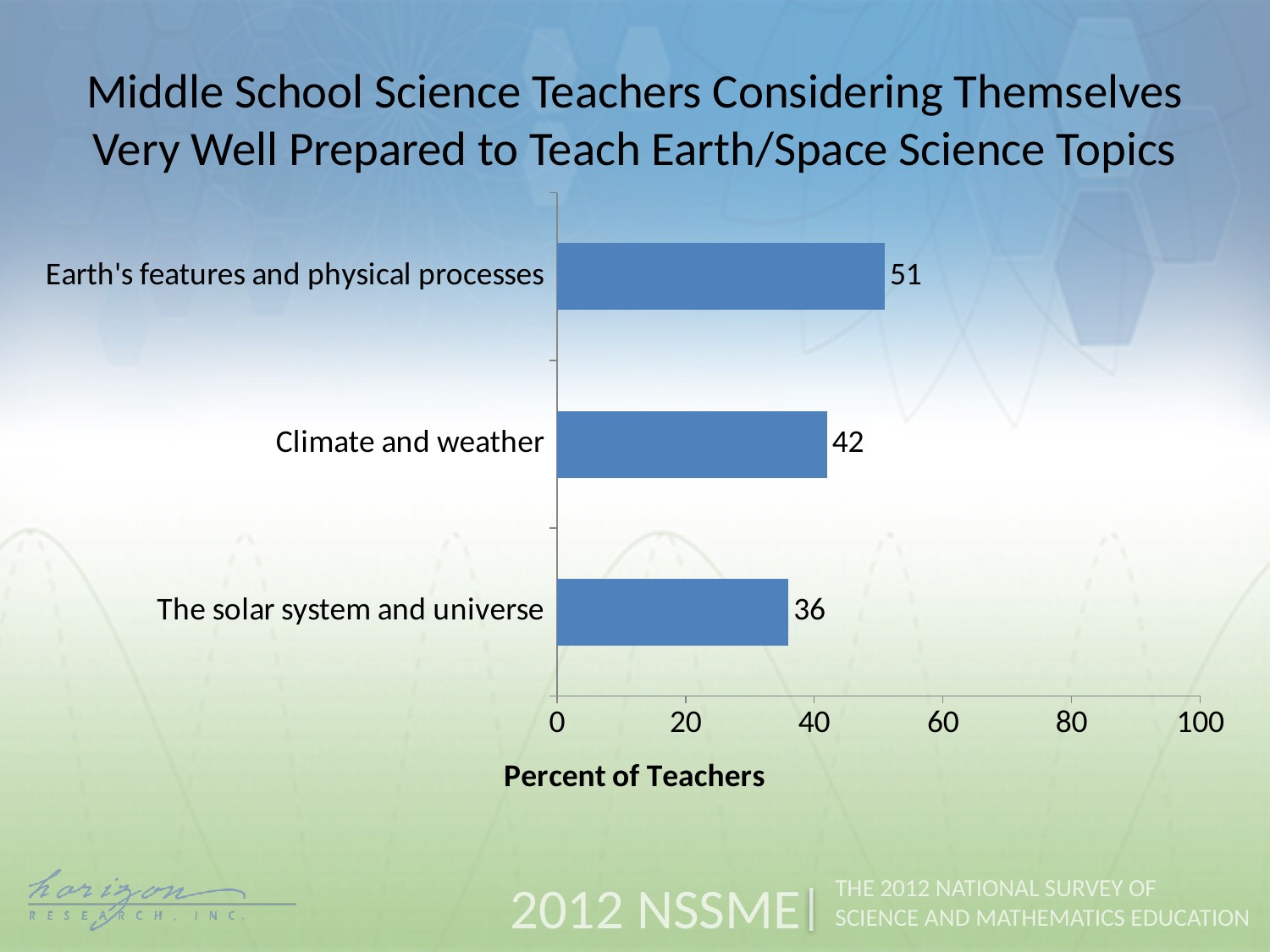
What is the label on the horizontal axis of the chart? Percent of Teachers What kind of chart is shown on the slide? bar chart Which topic has the lowest percent of teachers considering themselves very well prepared? The solar system and universe Which is larger, the value for Climate and weather or the value for The solar system and universe? Climate and weather Which topic has the highest percent of teachers considering themselves very well prepared? Earth's features and physical processes Is the value for Earth's features and physical processes greater or less than 60? less What percent of teachers consider themselves very well prepared to teach Earth's features and physical processes? 51 How many topics are shown in the chart? 3 What is the value for The solar system and universe? 36 What is the value for Climate and weather? 42 What is the difference between the values for Climate and weather and The solar system and universe? 6 What is the difference between the values for Earth's features and physical processes and The solar system and universe? 15